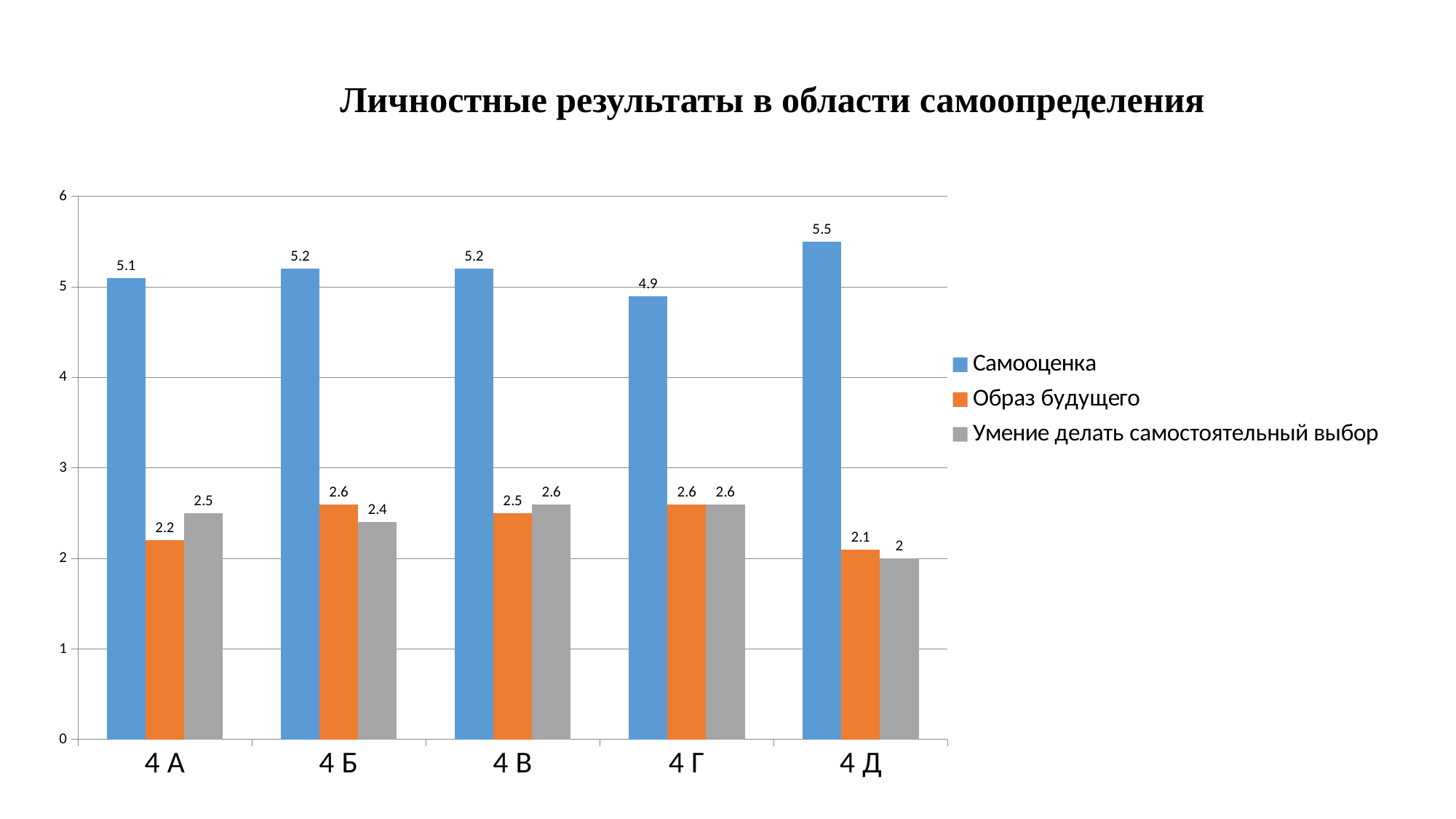
What is the value of Самооценка for 4 Д? 5.5 How many series does the legend list? 3 Which is larger for 4 А: Образ будущего or Умение делать самостоятельный выбор? Умение делать самостоятельный выбор Which class has the lowest Умение делать самостоятельный выбор value? 4 Д What is the value of Образ будущего for 4 А? 2.2 What kind of chart is shown on the slide? Bar chart What is the title of the chart? Личностные результаты в области самоопределения Which class has the highest Самооценка value? 4 Д Which class has the lowest Самооценка value? 4 Г How many classes are shown on the x axis? 5 What is the difference between the Самооценка values for 4 Д and 4 Г? 0.6 What is the value of Умение делать самостоятельный выбор for 4 Б? 2.4